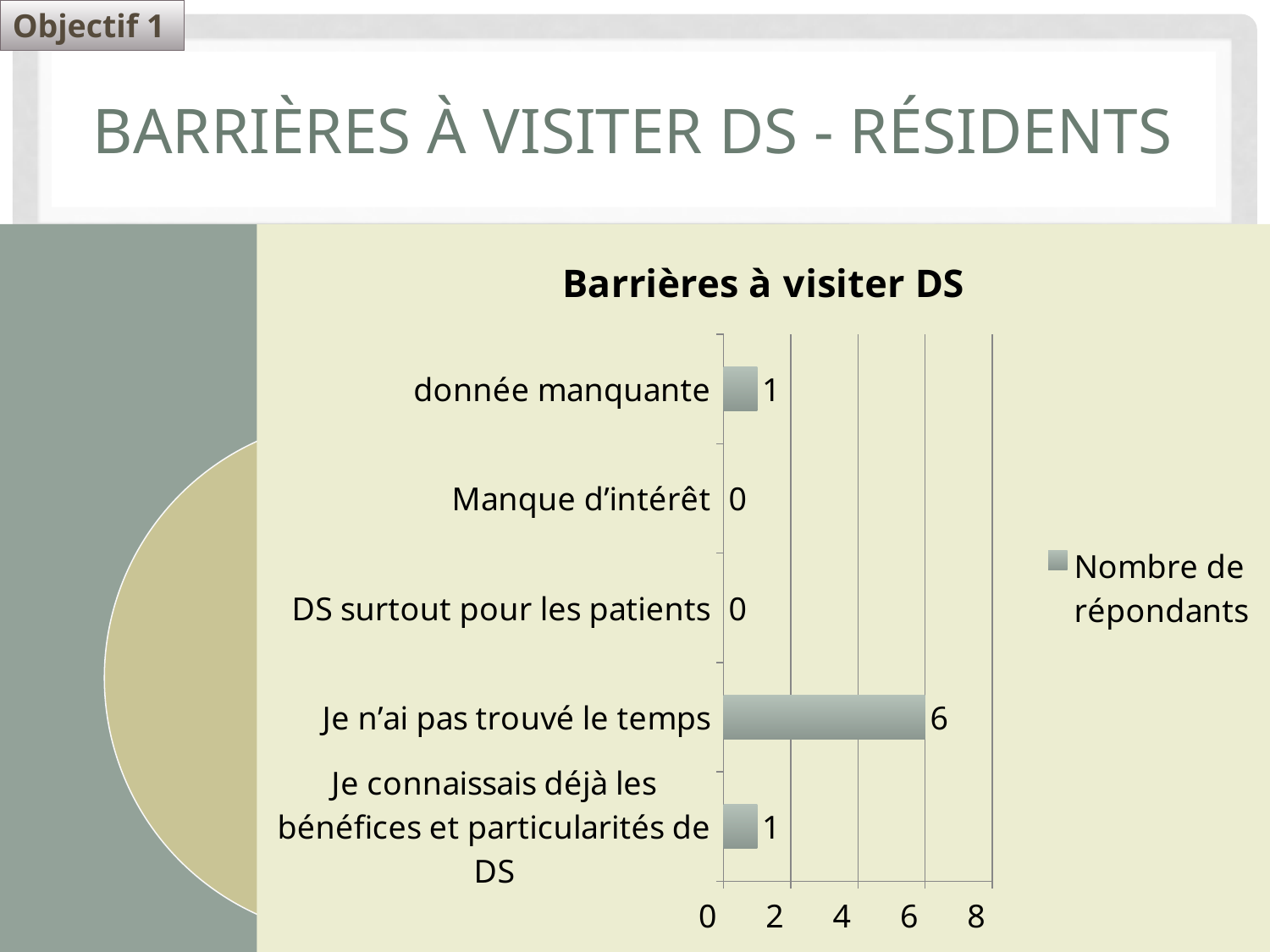
What is the value for "Je connaissais déjà les bénéfices et particularités de DS"? 1 How many categories are shown in the chart? 5 What is the title of the chart? Barrières à visiter DS Which category has the highest value? Je n'ai pas trouvé le temps Which is larger, the value for "Je n'ai pas trouvé le temps" or the value for "Manque d'intérêt"? Je n'ai pas trouvé le temps What kind of chart is shown? bar chart What is the value for "donnée manquante"? 1 What is the difference between the values for "Je n'ai pas trouvé le temps" and "donnée manquante"? 5 What is the value for "Manque d'intérêt"? 0 What is the value for "Je n'ai pas trouvé le temps"? 6 How many series does the legend list? 1 What is the value for "DS surtout pour les patients"? 0